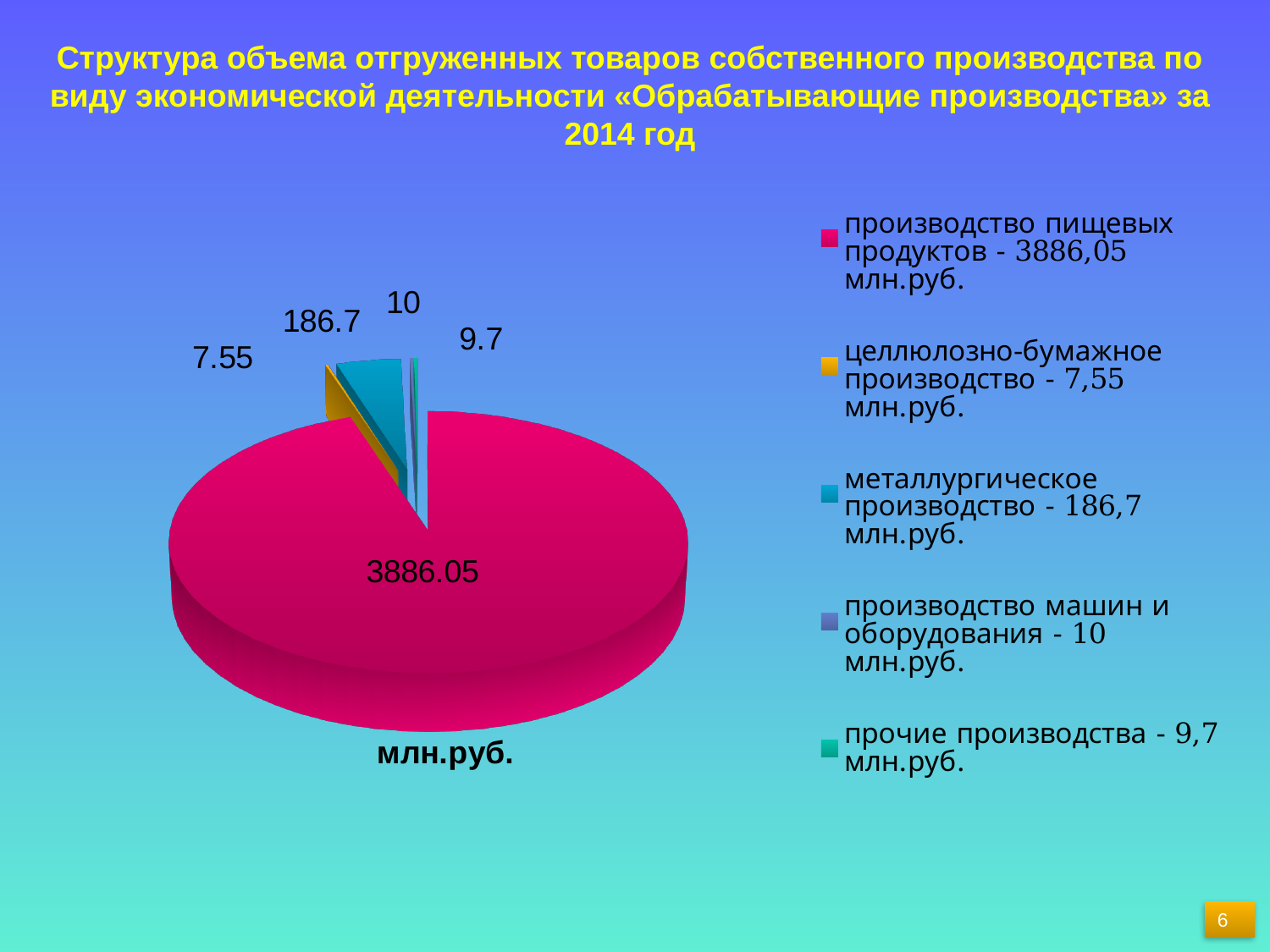
Which category has the largest slice of the pie? производство пищевых продуктов Which is larger: производство машин и оборудования or прочие производства? производство машин и оборудования How many slices does the pie chart have? 5 What is the value of the slice for производство пищевых продуктов? 3886.05 What is the value of the slice for прочие производства? 9.7 What is the difference between the values for производство пищевых продуктов and металлургическое производство? 3699.35 What is the value of the slice for металлургическое производство? 186.7 What is the total of all slice values in the pie chart? 4100 Which category has the smallest slice of the pie? целлюлозно-бумажное производство What unit label is shown beneath the pie chart? млн.руб. What type of chart is shown on the slide? pie chart What is the value of the slice for целлюлозно-бумажное производство? 7.55